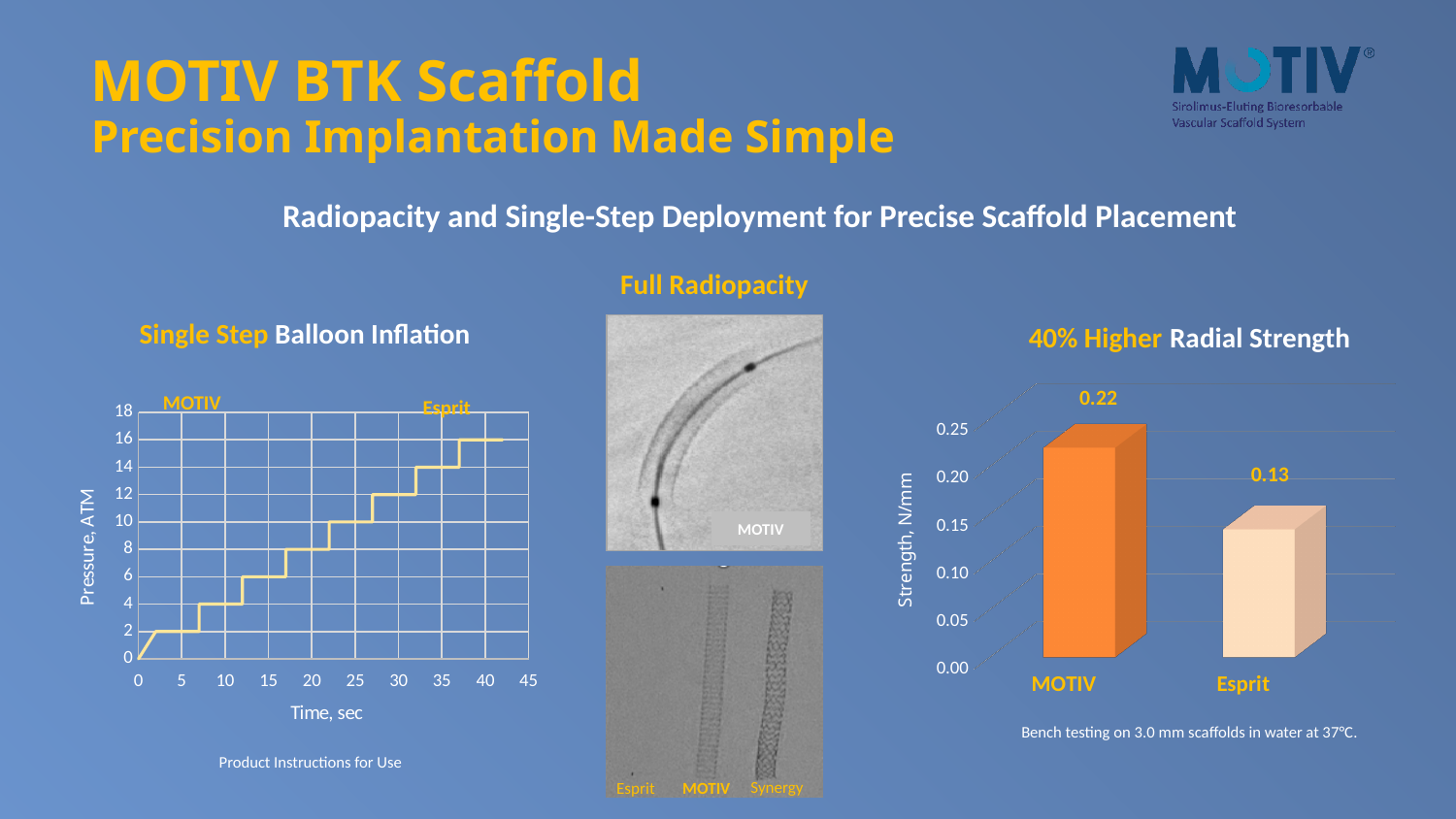
In the '40% Higher Radial Strength' chart, what kind of chart is shown? Bar chart In the '40% Higher Radial Strength' chart, what is the difference between the MOTIV and Esprit values? 0.09 In the 'Single Step Balloon Inflation' chart, what is the label on the horizontal axis? Time, sec In the '40% Higher Radial Strength' chart, which category has the lowest value? Esprit In the '40% Higher Radial Strength' chart, how many categories are plotted? 2 In the 'Single Step Balloon Inflation' chart, is the pressure at 40 sec greater or less than 14 ATM? greater In the '40% Higher Radial Strength' chart, what is the label on the vertical axis? Strength, N/mm In the '40% Higher Radial Strength' chart, which category has the highest value? MOTIV In the '40% Higher Radial Strength' chart, what is the strength value for MOTIV? 0.22 In the '40% Higher Radial Strength' chart, what is the strength value for Esprit? 0.13 In the 'Single Step Balloon Inflation' chart, does the pressure rise or fall as time increases? Rise